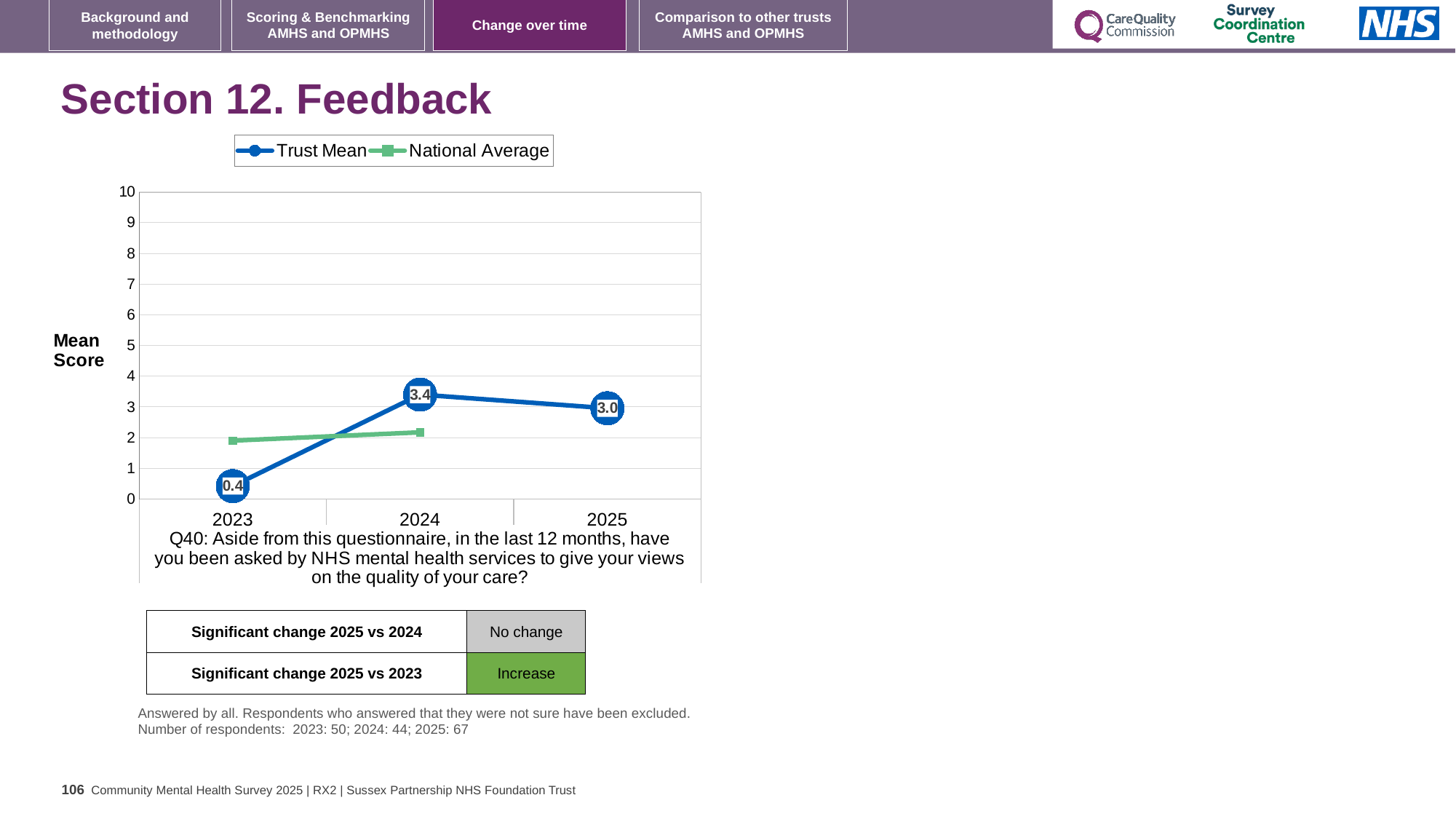
What is the Trust Mean score for 2025? 3.0 How many series does the legend list? 2 What is the Trust Mean score for 2023? 0.4 What kind of chart is shown on the slide? line chart What is the Trust Mean score for 2024? 3.4 In which year is the Trust Mean score highest? 2024 Is the National Average value for 2023 greater or less than 3? less Which is larger, the Trust Mean score for 2025 or for 2023? 2025 Does the Trust Mean score rise or fall from 2024 to 2025? fall What is the difference between the Trust Mean scores for 2024 and 2025? 0.4 What is the difference between the Trust Mean scores for 2024 and 2023? 3.0 In which year is the Trust Mean score lowest? 2023